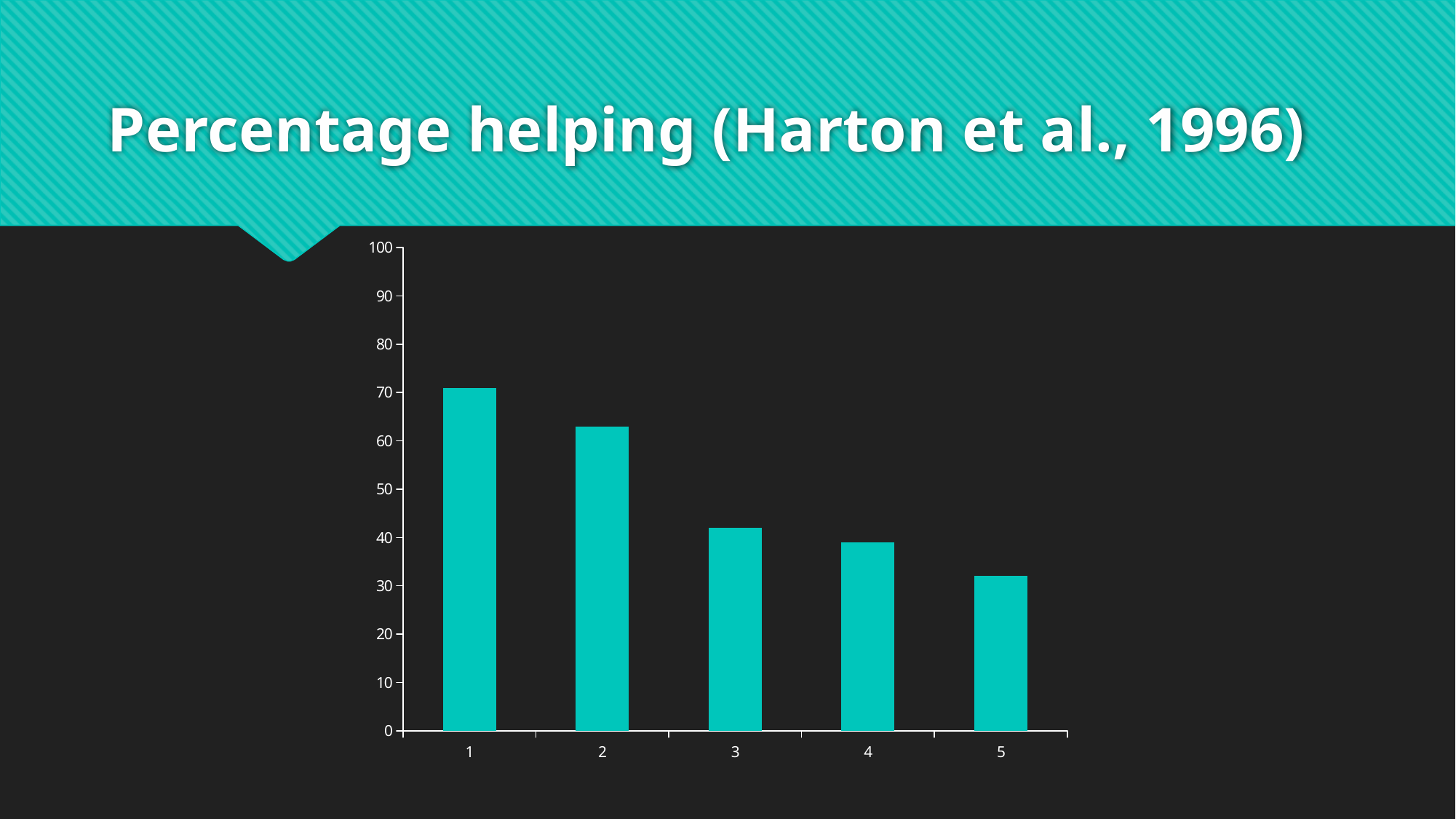
Which category has the highest bar? 1 Is the value for category 3 greater or less than 50? less Which is larger, the value for category 1 or category 2? 1 Is the value for category 4 greater or less than 30? greater Which is larger, the value for category 4 or category 5? 4 How many bars are plotted in the chart? 5 Do the values rise or fall as you move from category 1 to category 5? fall Which category has the lowest bar? 5 Is the value for category 5 greater or less than 40? less What kind of chart is shown on the slide? bar chart What is the title of the slide containing the chart? Percentage helping (Harton et al., 1996)